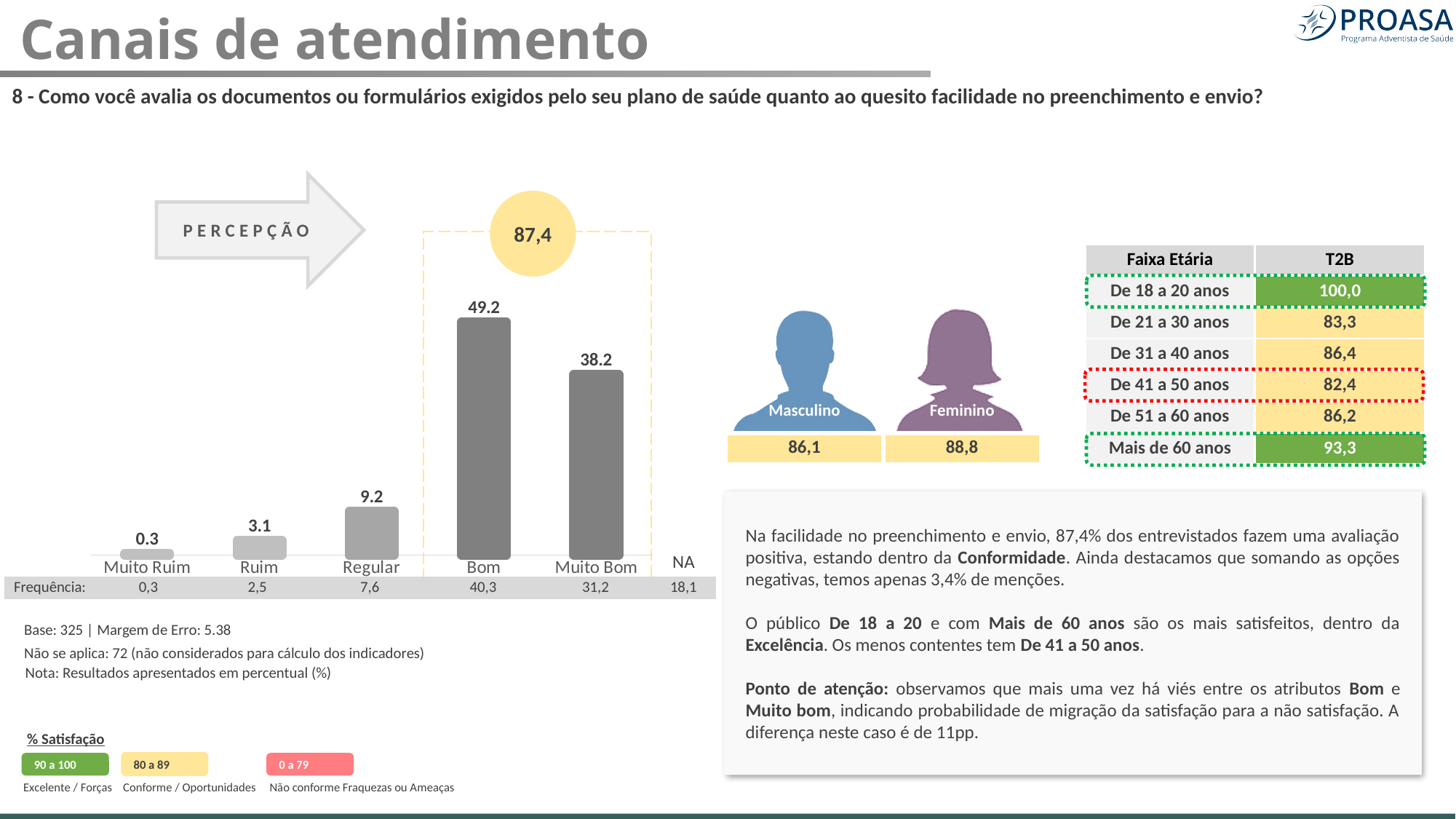
What is the value for Muito Ruim in the bar chart? 0.3 Which is larger, the value for Ruim or the value for Regular? Regular What is the value for Bom in the bar chart? 49.2 Which category has the lowest value among the plotted bars? Muito Ruim What is the difference between the values for Regular and Ruim? 6.1 What is the value for Muito Bom in the bar chart? 38.2 What kind of chart is shown on the slide? bar chart Which category has the highest value in the bar chart? Bom What is the difference between the values for Bom and Muito Bom? 11 What is the Frequência value shown below the Bom bar? 40,3 What value is shown in the yellow circle above the Bom and Muito Bom bars? 87,4 What is the value for Regular in the bar chart? 9.2